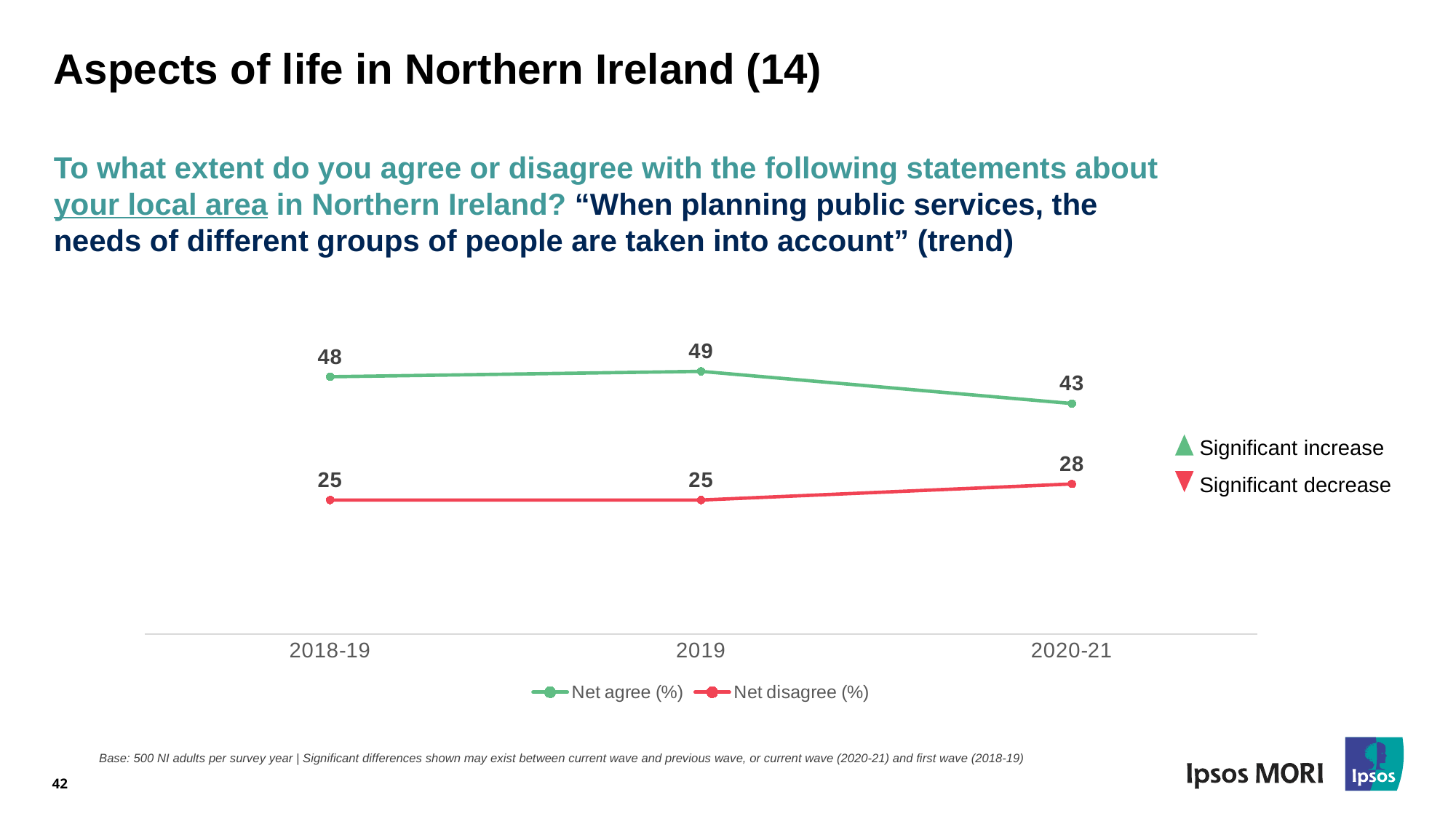
Does Net disagree (%) rise or fall from 2019 to 2020-21? Rise How many series does the legend list? 2 What is the Net disagree (%) value for 2020-21? 28 How many survey years are plotted on the x axis? 3 What is the Net agree (%) value for 2018-19? 48 In which year is Net agree (%) highest? 2019 What kind of chart is shown on the slide? Line chart What is the Net agree (%) value for 2019? 49 By how much did Net agree (%) fall from 2019 to 2020-21? 6 In which year is Net agree (%) lowest? 2020-21 Which is larger in 2018-19, Net agree (%) or Net disagree (%)? Net agree (%) What is the difference between Net agree (%) and Net disagree (%) in 2020-21? 15